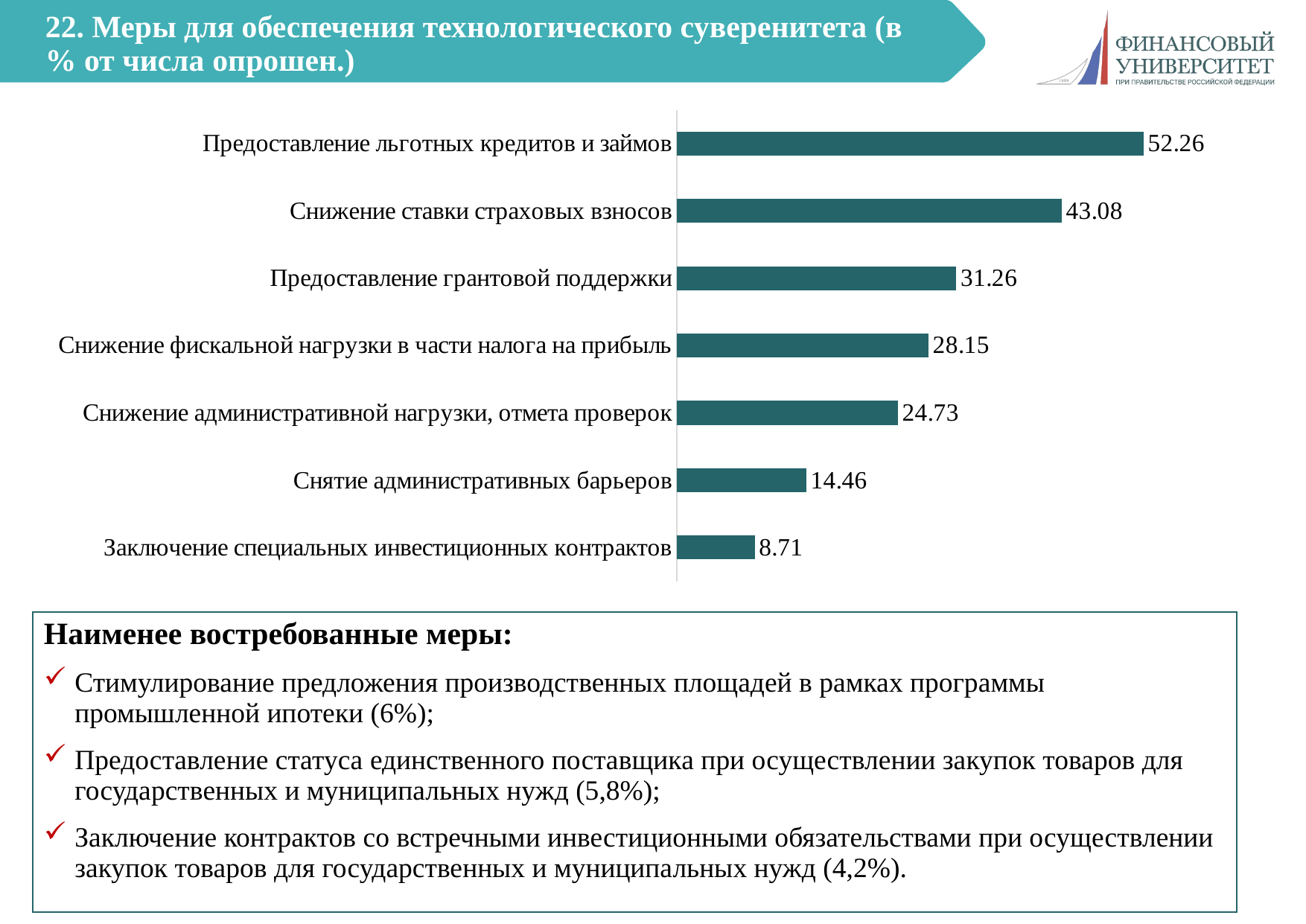
What is the difference between «Предоставление грантовой поддержки» and «Снижение фискальной нагрузки в части налога на прибыль»? 3.11 What is the difference between «Предоставление льготных кредитов и займов» and «Снижение ставки страховых взносов»? 9.18 Which measure has the highest value? Предоставление льготных кредитов и займов What is the value for «Предоставление льготных кредитов и займов»? 52.26 What is the title of the chart on the slide? 22. Меры для обеспечения технологического суверенитета (в % от числа опрошен.) What is the value for «Снижение административной нагрузки, отмета проверок»? 24.73 Which is larger: «Снятие административных барьеров» or «Снижение административной нагрузки, отмета проверок»? Снижение административной нагрузки, отмета проверок Which measure has the lowest value? Заключение специальных инвестиционных контрактов What is the value for «Снижение ставки страховых взносов»? 43.08 How many measures are shown in the chart? 7 What is the value for «Заключение специальных инвестиционных контрактов»? 8.71 What kind of chart is shown on the slide? Bar chart